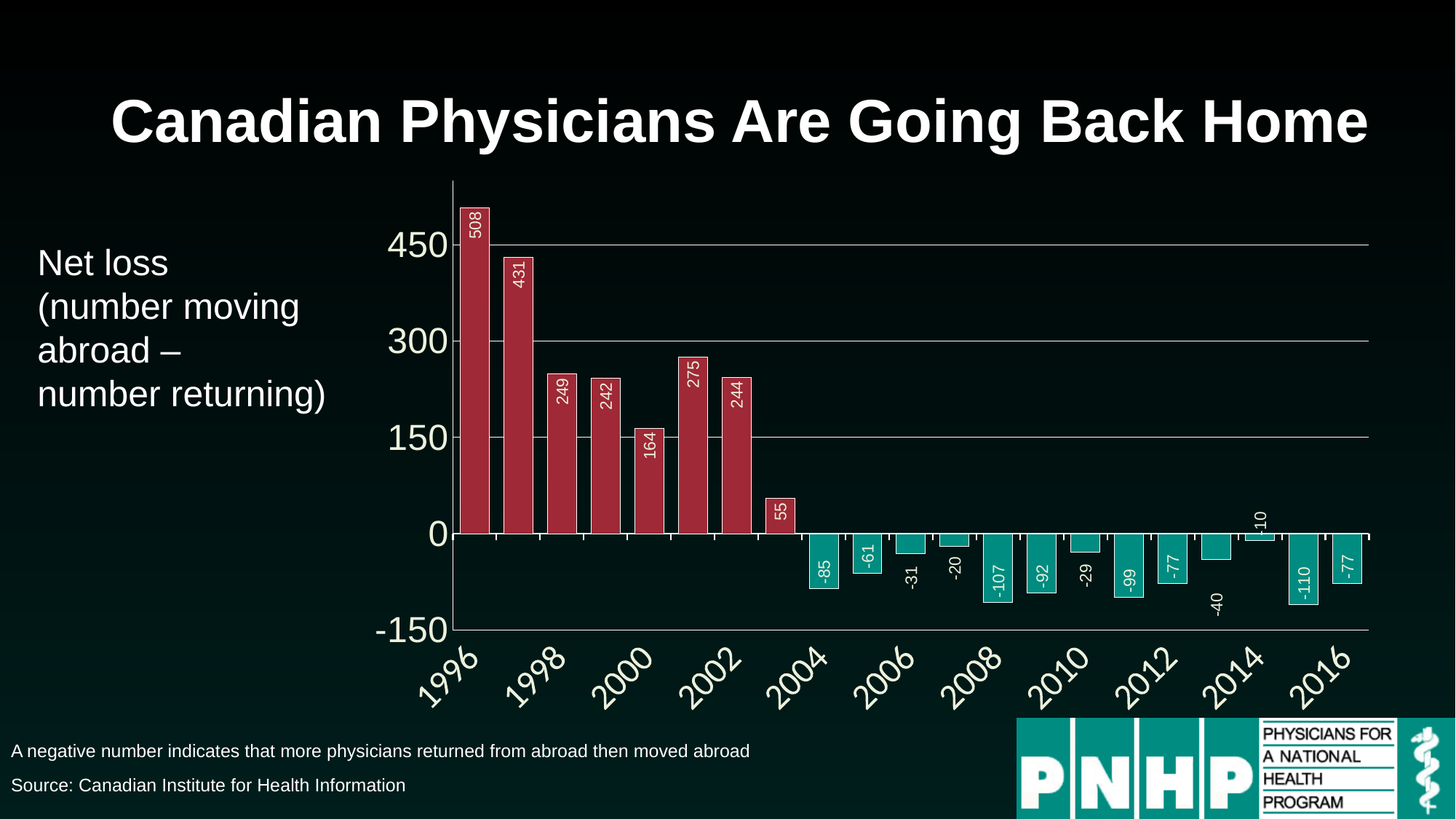
What is the net loss value for 2000? 164 What is the difference between the net loss values for 1996 and 1998? 259 Which year has the lowest net loss value? 2015 What is the net loss value for 1996? 508 Which year has a larger net loss value, 2002 or 2004? 2002 What kind of chart is shown on the slide? bar chart Do the net loss values generally rise or fall from 1996 to 2016? fall Which year has the highest net loss value? 1996 Is the value for 2014 greater or less than -150? greater What is the net loss value for 2008? -107 What is the net loss value for 2016? -77 How many years (bars) are plotted in the chart? 21